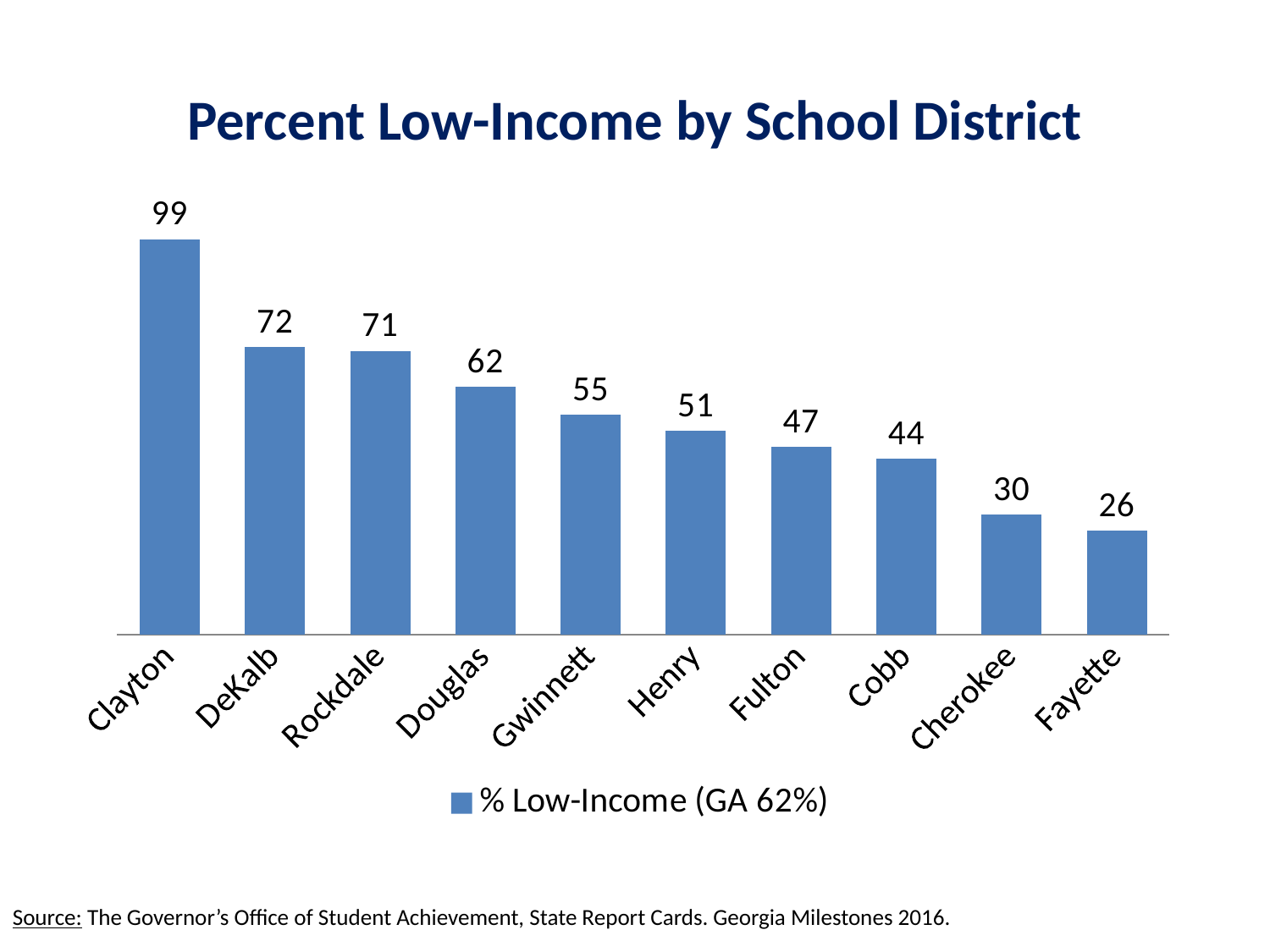
How many series does the legend list? 1 Which school district has the lowest percent low-income? Fayette Which school district has the highest percent low-income? Clayton Which has a higher percent low-income, Henry or Cobb? Henry What is the percent low-income value for Gwinnett? 55 Do the values rise or fall from left to right across the districts? Fall What kind of chart is shown on the slide? Bar chart What is the percent low-income value for Clayton? 99 What is the percent low-income value for Cherokee? 30 How many school districts are shown in the chart? 10 What is the difference between the values for DeKalb and Douglas? 10 What is the difference between the values for Clayton and Fayette? 73